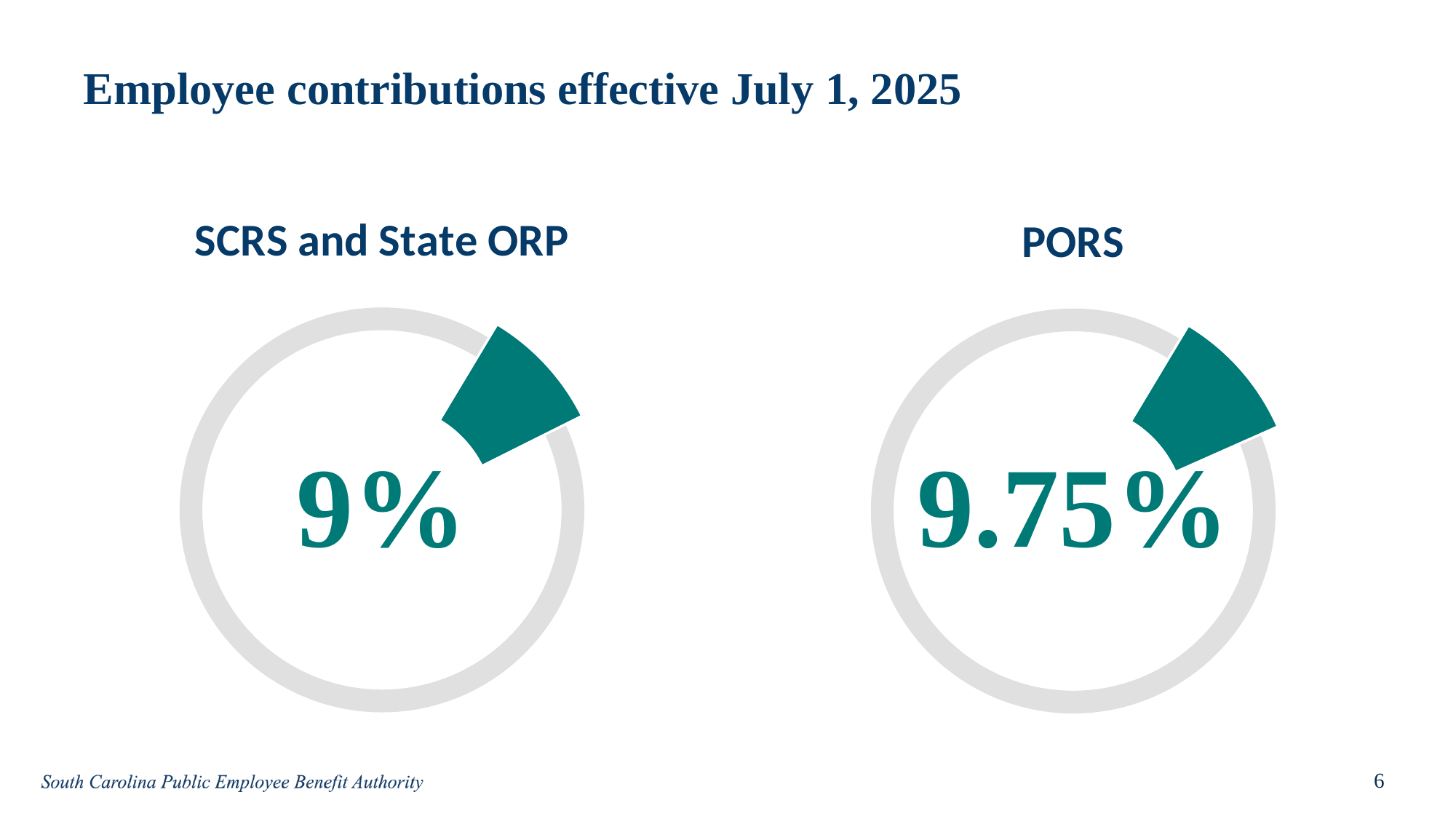
What is the difference between the PORS rate and the SCRS and State ORP rate? 0.75% Is the value shown in the PORS chart greater or less than 10%? less What colour is the highlighted segment in the PORS chart? Teal In the SCRS and State ORP chart, what employee contribution rate is shown? 9% How many charts are shown on the slide? 2 In the PORS chart, what employee contribution rate is shown? 9.75% Which chart shows the higher contribution rate, SCRS and State ORP or PORS? PORS What kind of chart is used to show the SCRS and State ORP contribution rate? Doughnut chart What is the title of the slide containing the two charts? Employee contributions effective July 1, 2025